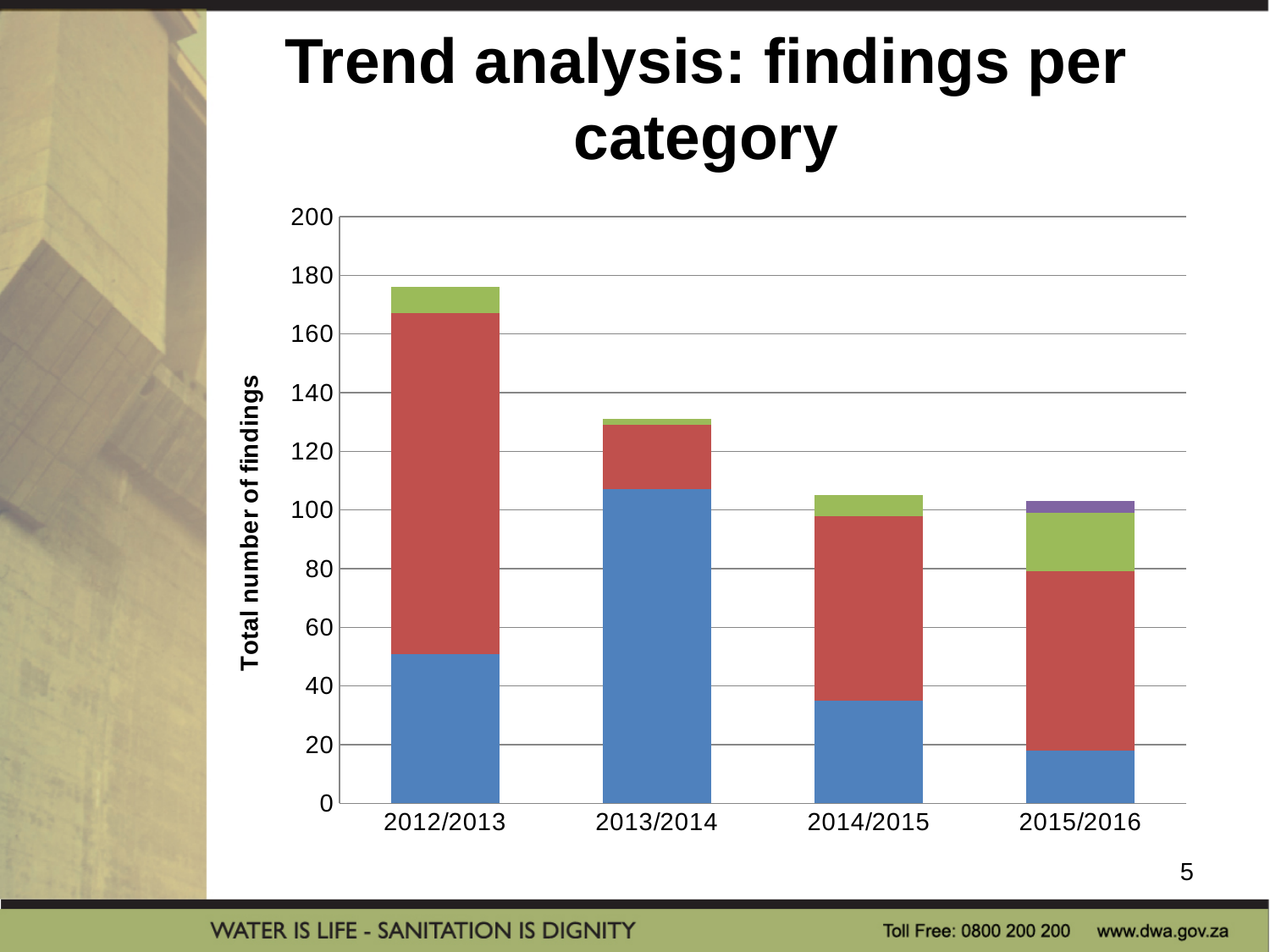
Is the total number of findings for 2014/2015 greater or less than 120? less Is the total number of findings for 2013/2014 greater or less than 120? greater Which year has the smallest blue segment? 2015/2016 What is the label on the vertical axis of the chart? Total number of findings Is the total number of findings for 2015/2016 greater or less than 120? less How many financial years are shown on the x axis of the chart? 4 What kind of chart is shown on the slide? stacked bar chart Which year has the highest total number of findings? 2012/2013 Which year has a larger total number of findings, 2012/2013 or 2013/2014? 2012/2013 Which year has the largest blue segment? 2013/2014 Do the total findings generally rise or fall from 2012/2013 to 2015/2016? fall